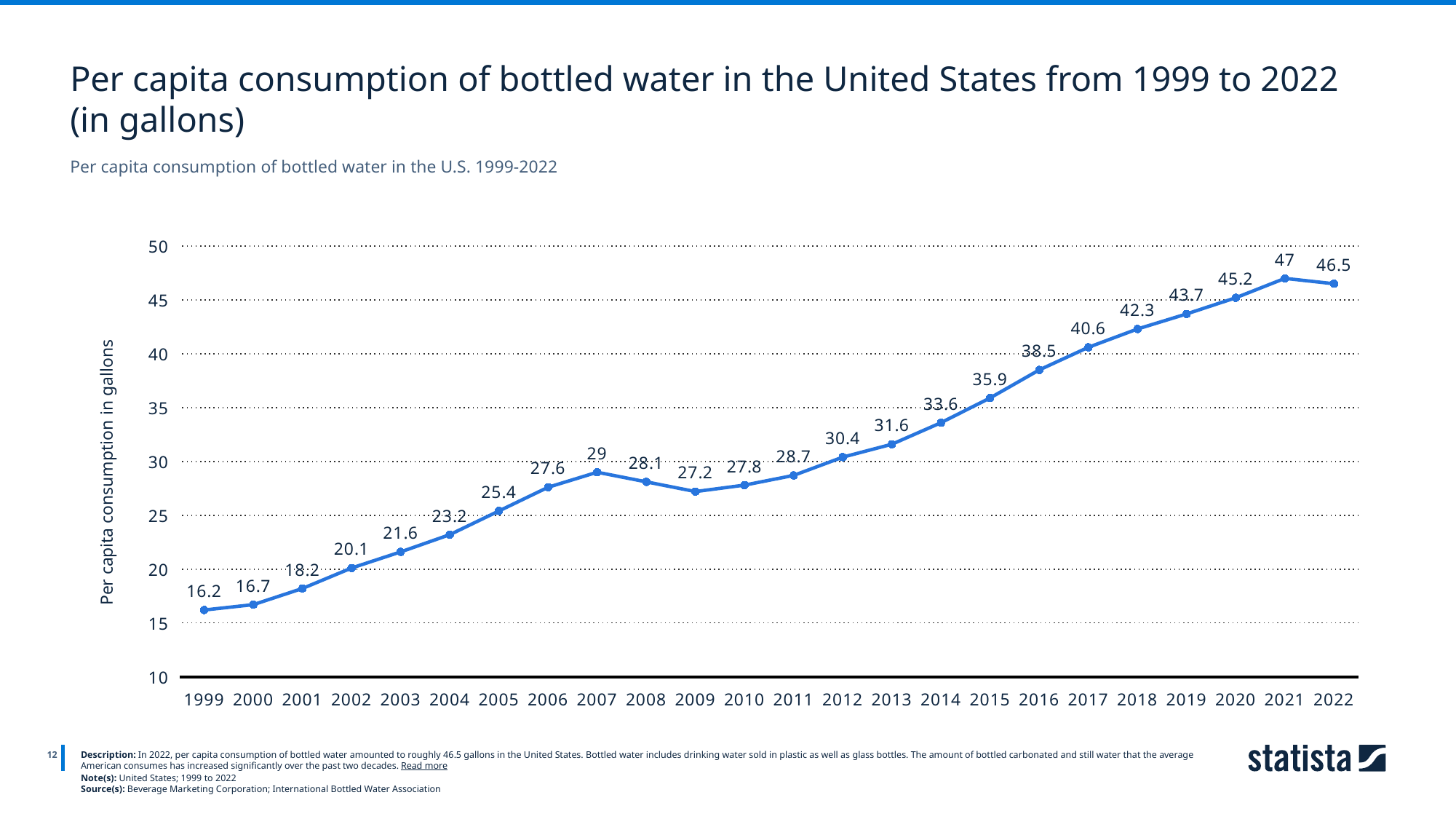
What was the per capita consumption of bottled water in 1999? 16.2 What value is shown for 2007? 29 What type of chart is shown on the slide? Line chart Is the value for 2016 greater or less than 40? less How many years are plotted on the chart? 24 Which year has the lowest per capita consumption of bottled water? 1999 Which year has the highest per capita consumption of bottled water? 2021 What was the per capita consumption of bottled water in the United States in 2022? 46.5 Which year has a higher value, 2008 or 2009? 2008 What is the difference between the values for 2022 and 1999? 30.3 What is the difference between the values for 2021 and 2022? 0.5 What is the label of the y axis? Per capita consumption in gallons